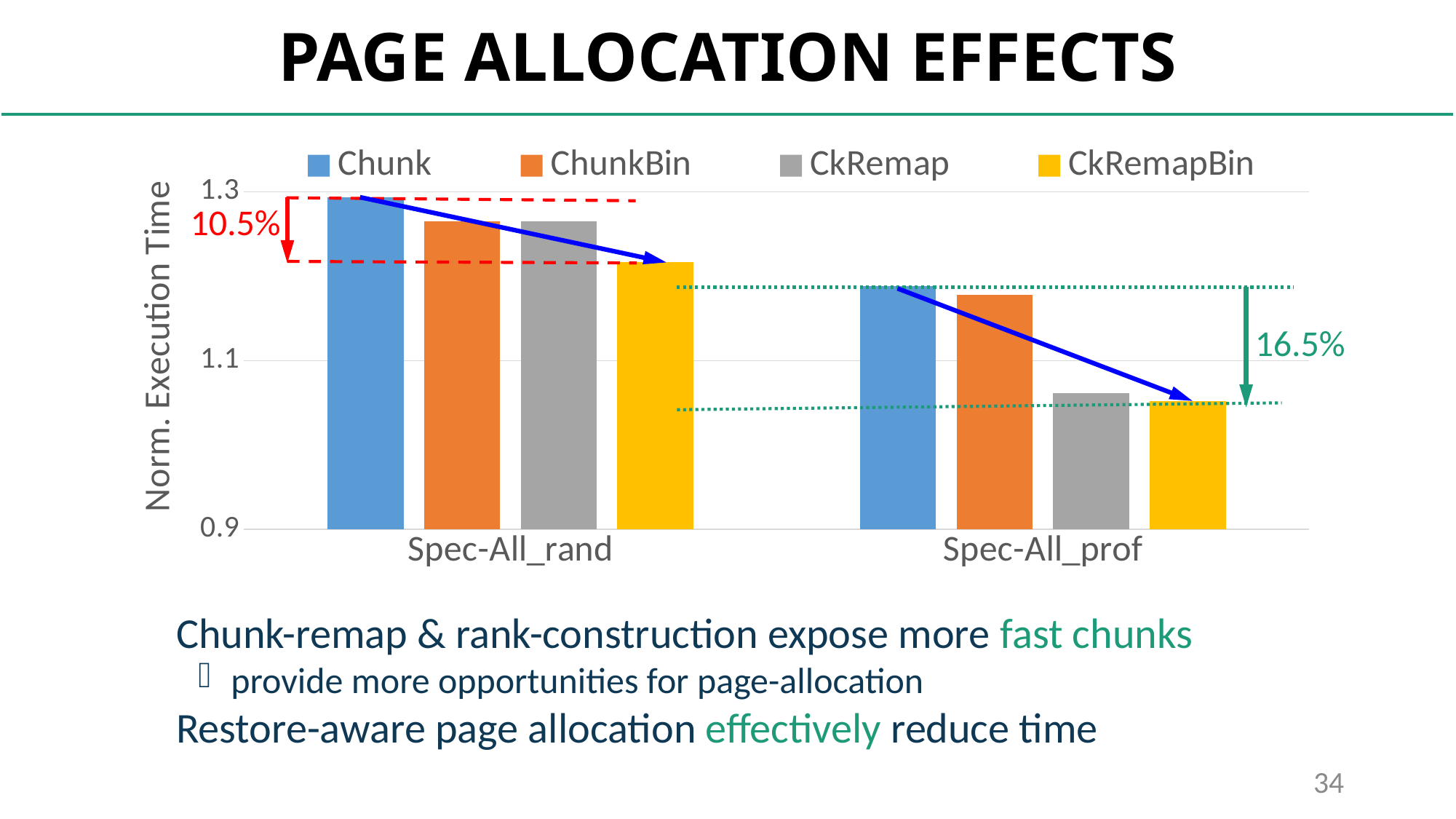
Is the value for CkRemapBin in Spec-All_rand greater or less than 1.1? greater Which is larger: the Chunk value for Spec-All_rand or the Chunk value for Spec-All_prof? Spec-All_rand Which series has the lowest normalized execution time for Spec-All_rand? CkRemapBin Is the value for CkRemap in Spec-All_prof greater or less than 1.1? less What kind of chart is shown on the slide? bar chart How many categories are shown on the x axis? 2 What percentage reduction is annotated in red for Spec-All_rand? 10.5% How many series does the legend list? 4 Is the value for Chunk in Spec-All_prof greater or less than 1.1? greater What is the label of the y axis? Norm. Execution Time Which series has the highest normalized execution time for Spec-All_prof? Chunk Which series has the highest normalized execution time for Spec-All_rand? Chunk